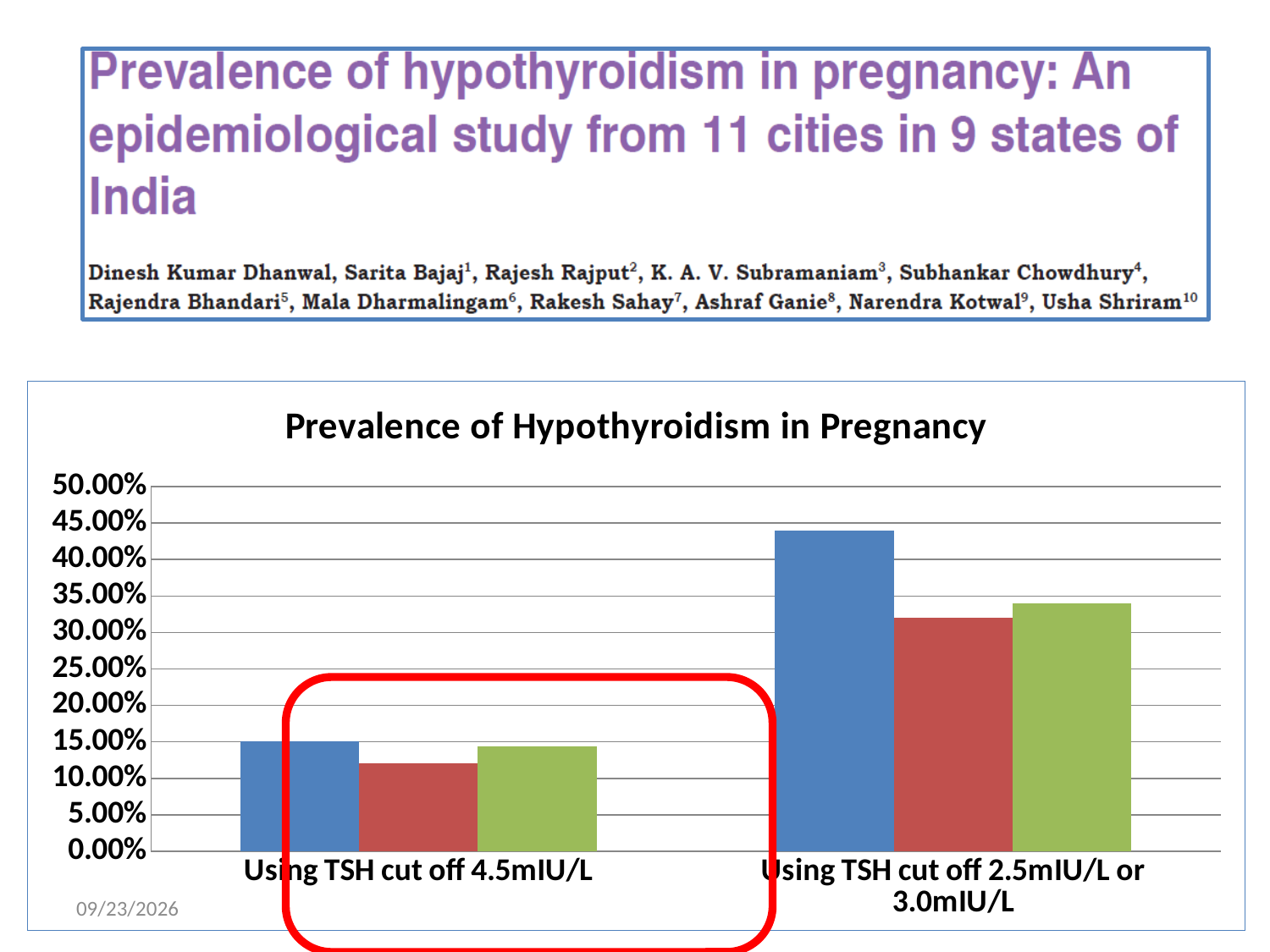
Which category contains the tallest bar in the chart? Using TSH cut off 2.5mIU/L or 3.0mIU/L Which is larger: the blue bar for 'Using TSH cut off 4.5mIU/L' or the blue bar for 'Using TSH cut off 2.5mIU/L or 3.0mIU/L'? Using TSH cut off 2.5mIU/L or 3.0mIU/L Is the value of the red bar for 'Using TSH cut off 2.5mIU/L or 3.0mIU/L' greater or less than 30.00%? greater Is the value of the red bar for 'Using TSH cut off 4.5mIU/L' greater or less than 15.00%? less Is the value of the blue bar for 'Using TSH cut off 2.5mIU/L or 3.0mIU/L' greater or less than 40.00%? greater What kind of chart is shown on the slide? bar chart How many categories are shown on the x axis of the chart? 2 What is the title of the chart? Prevalence of Hypothyroidism in Pregnancy Which category contains the shortest bar in the chart? Using TSH cut off 4.5mIU/L Do the values rise or fall from the first category to the second category along the x axis? rise How many bars are plotted for each category in the chart? 3